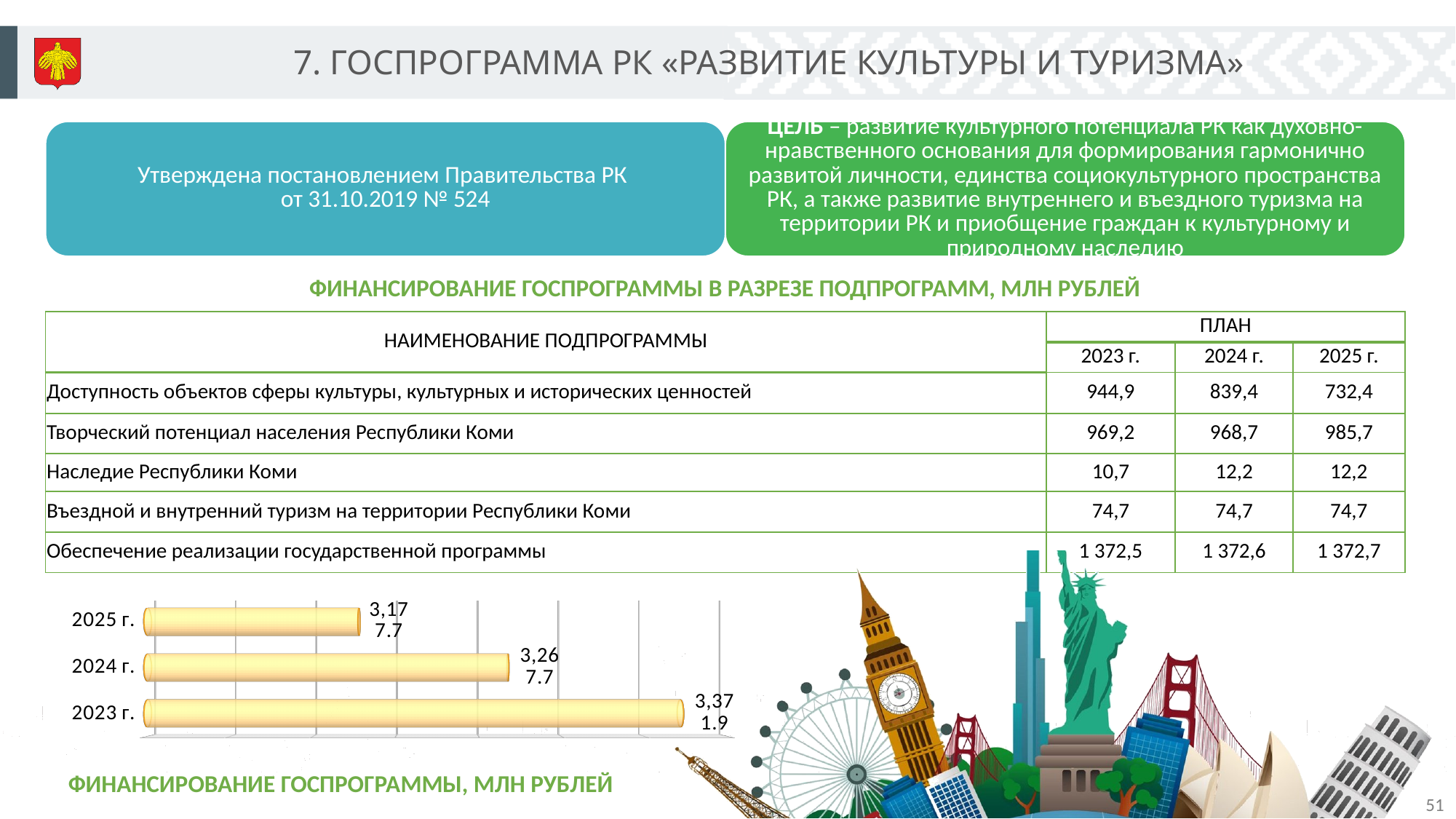
In the bar chart at the bottom left, which year has the longest bar? 2023 г. Are the bars in the chart at the bottom left horizontal or vertical? horizontal What is the title of the bar chart at the bottom left of the slide? ФИНАНСИРОВАНИЕ ГОСПРОГРАММЫ, МЛН РУБЛЕЙ Which year is listed at the top of the bar chart at the bottom left? 2025 г. What kind of chart is shown at the bottom left of the slide? bar chart In the bar chart at the bottom left, which bar is longer: 2024 г. or 2025 г.? 2024 г. In the bar chart at the bottom left, do the bar lengths increase or decrease from 2023 г. to 2025 г.? decrease How many bars (years) does the bar chart at the bottom left show? 3 In the bar chart at the bottom left, which bar is longer: 2023 г. or 2025 г.? 2023 г. In the bar chart at the bottom left, which year has the shortest bar? 2025 г.